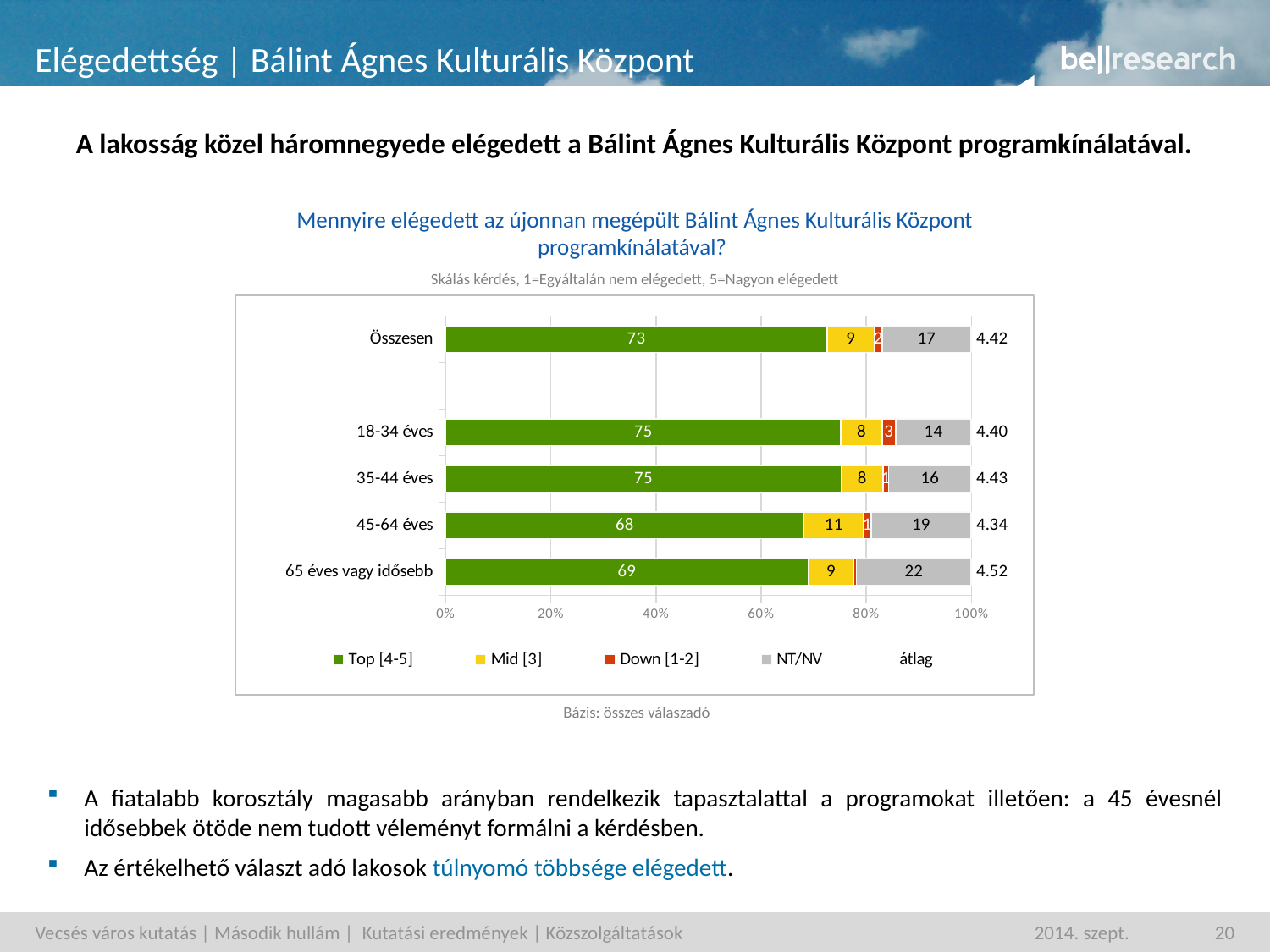
Which category has the lowest Top [4-5] value? 45-64 éves What is the Top [4-5] value for the 18-34 éves category? 75 What is the difference between the NT/NV values for 65 éves vagy idősebb and 18-34 éves? 8 What is the NT/NV value for the 65 éves vagy idősebb category? 22 What is the átlag (average) shown for the Összesen row? 4.42 What is the Mid [3] value for the 45-64 éves category? 11 How many age-group categories (excluding Összesen) are plotted on the chart? 4 What kind of chart is shown on the slide? Stacked bar chart How many entries does the legend list? 5 Which is larger, the Down [1-2] value for 18-34 éves or for 35-44 éves? 18-34 éves Which category has the highest átlag value? 65 éves vagy idősebb What colour represents the Top [4-5] series in the chart? Green